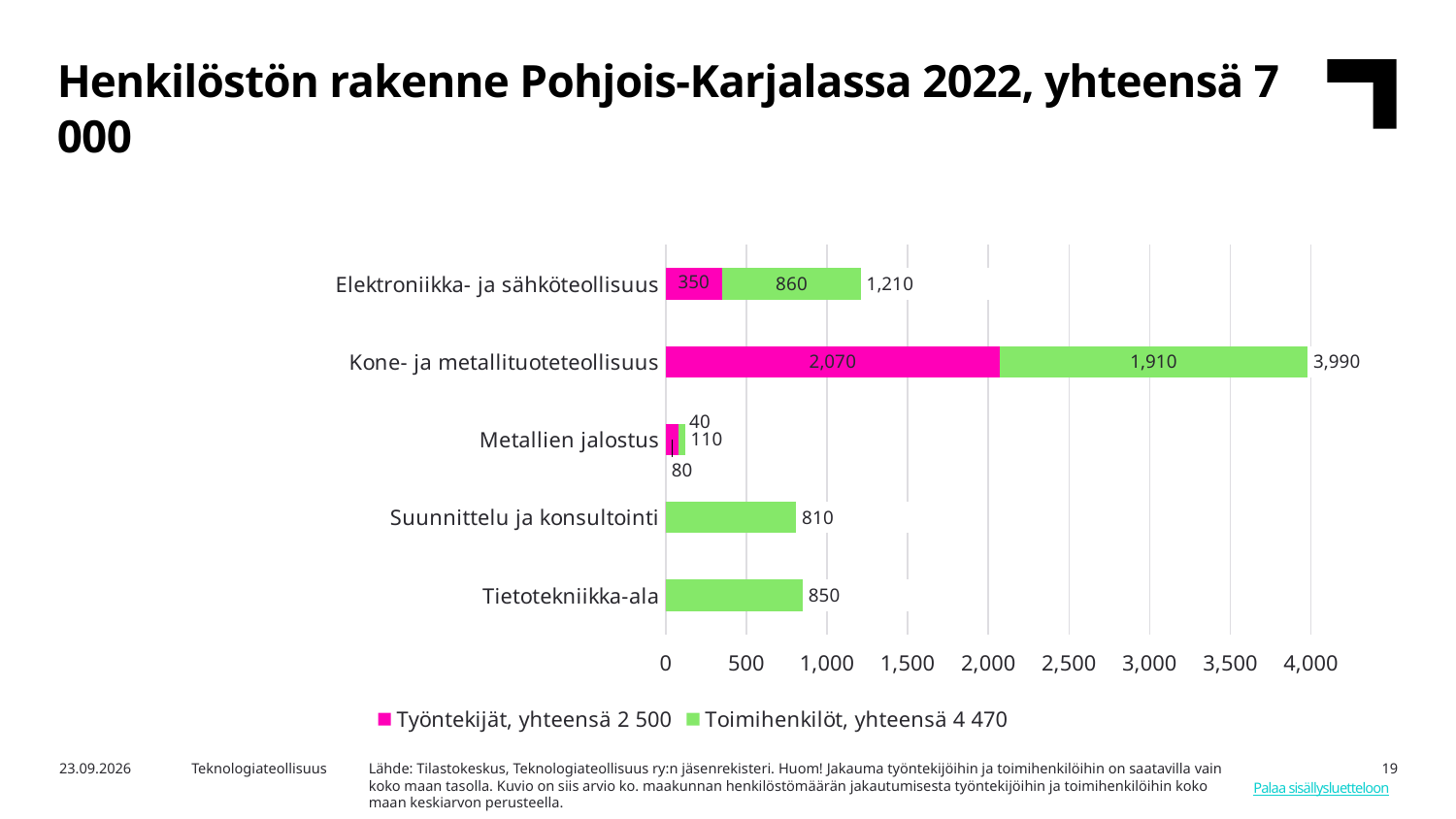
How many categories are shown on the chart? 5 For Kone- ja metallituoteteollisuus, which is larger: the Työntekijät value or the Toimihenkilöt value? Työntekijät What is the Työntekijät value for Kone- ja metallituoteteollisuus? 2,070 What is the Toimihenkilöt value for Suunnittelu ja konsultointi? 810 What is the total of the stacked bar for Kone- ja metallituoteteollisuus? 3,990 Which category has the largest total bar? Kone- ja metallituoteteollisuus How many series does the legend list? 2 What is the difference between the Toimihenkilöt values for Tietotekniikka-ala and Suunnittelu ja konsultointi? 40 What kind of chart is shown on the slide? bar chart What is the Toimihenkilöt value for Elektroniikka- ja sähköteollisuus? 860 What is the legend entry for the pink series? Työntekijät, yhteensä 2 500 Which category has the smallest total bar? Metallien jalostus